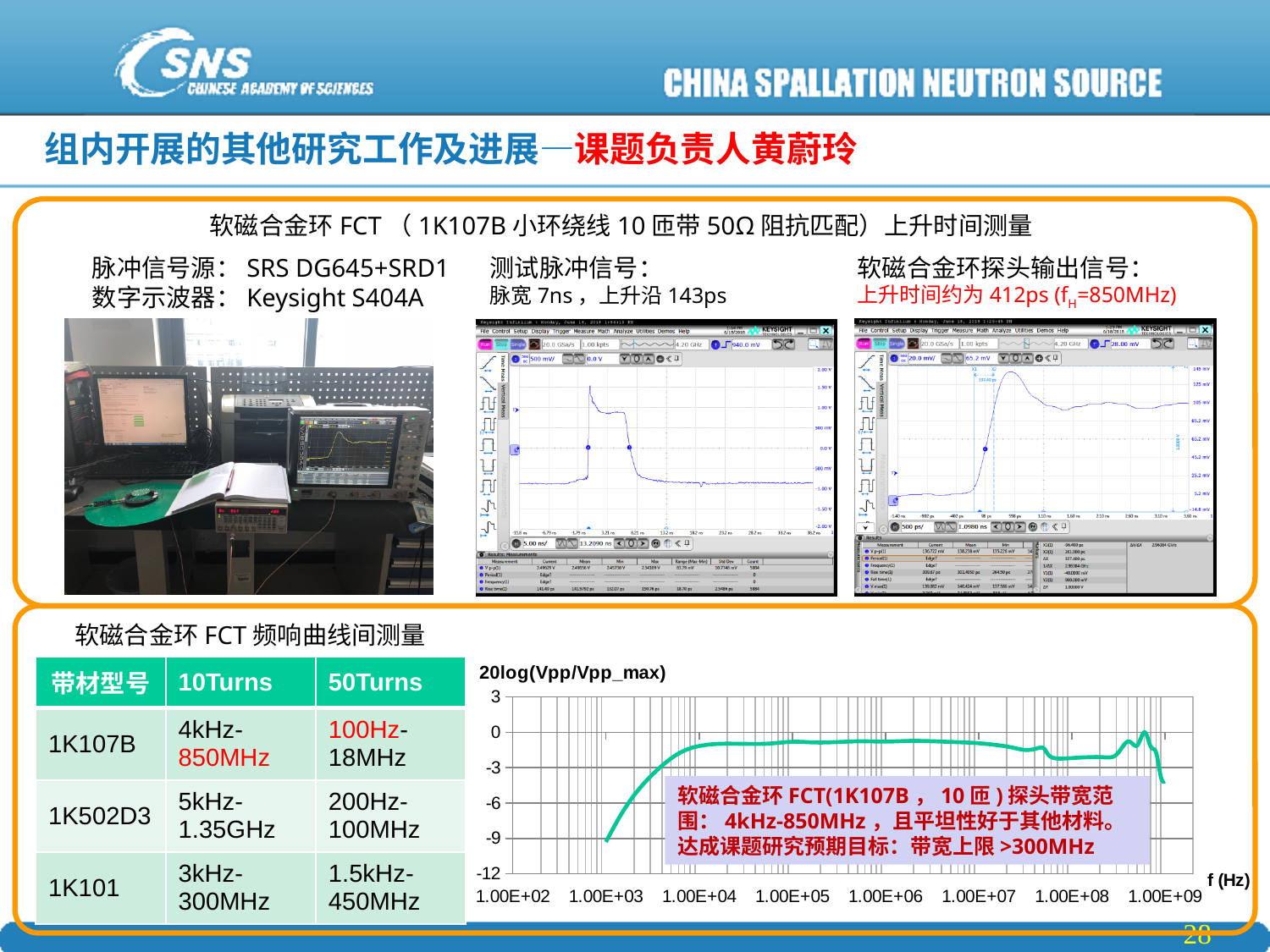
In the frequency response chart, what is the largest frequency tick shown on the x axis? 1.00E+09 In the frequency response chart, what is the label of the y axis? 20log(Vpp/Vpp_max) In the frequency response chart, how many tick labels are shown along the x axis? 8 In the frequency response chart, what is the lowest value shown on the y axis? -12 In the frequency response chart, what is the smallest frequency tick shown on the x axis? 1.00E+02 In the frequency response chart, how many curves are plotted? 1 In the frequency response chart, is the lowest point of the curve (at its left end) greater or less than -6? less What kind of chart is the frequency response chart at the bottom right of the slide? line chart In the frequency response chart, does the curve rise or fall as frequency increases from 1.00E+03 Hz to 1.00E+04 Hz? rise In the frequency response chart, is the value of the curve at 1.00E+06 Hz greater or less than -3? greater In the frequency response chart, what is the highest value shown on the y axis? 3 In the frequency response chart, what is the label of the x axis? f (Hz)